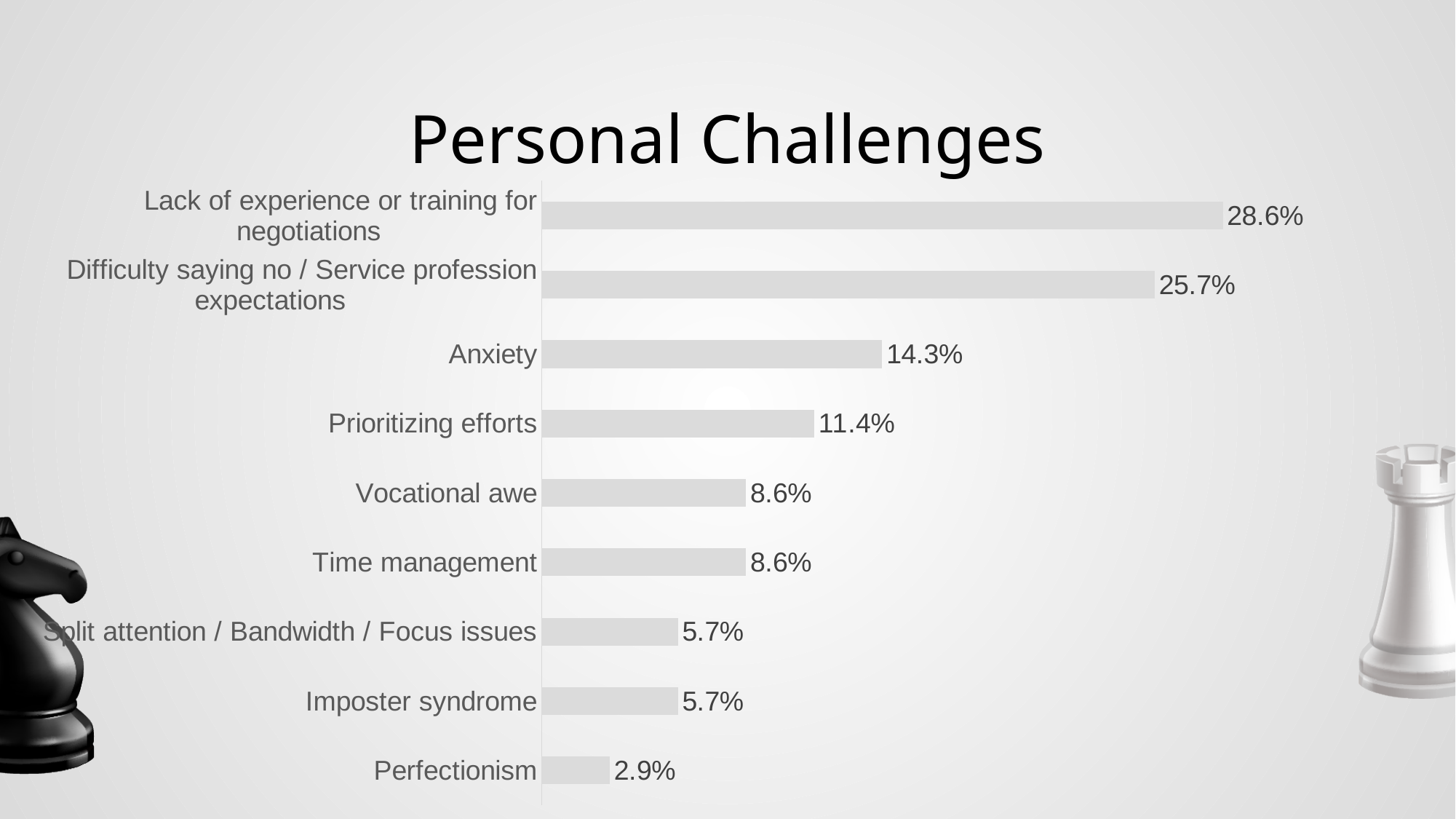
What is the title of the chart? Personal Challenges What is the value for Anxiety? 14.3% Which category has the lowest value? Perfectionism What is the difference between the values for Lack of experience or training for negotiations and Difficulty saying no / Service profession expectations? 2.9% Which is larger, the value for Anxiety or the value for Vocational awe? Anxiety What is the difference between the values for Anxiety and Prioritizing efforts? 2.9% What kind of chart is shown on the slide? Bar chart How many categories are shown in the chart? 9 What is the value for Perfectionism? 2.9% What is the value for Difficulty saying no / Service profession expectations? 25.7% Which category has the highest value? Lack of experience or training for negotiations What is the value for Prioritizing efforts? 11.4%